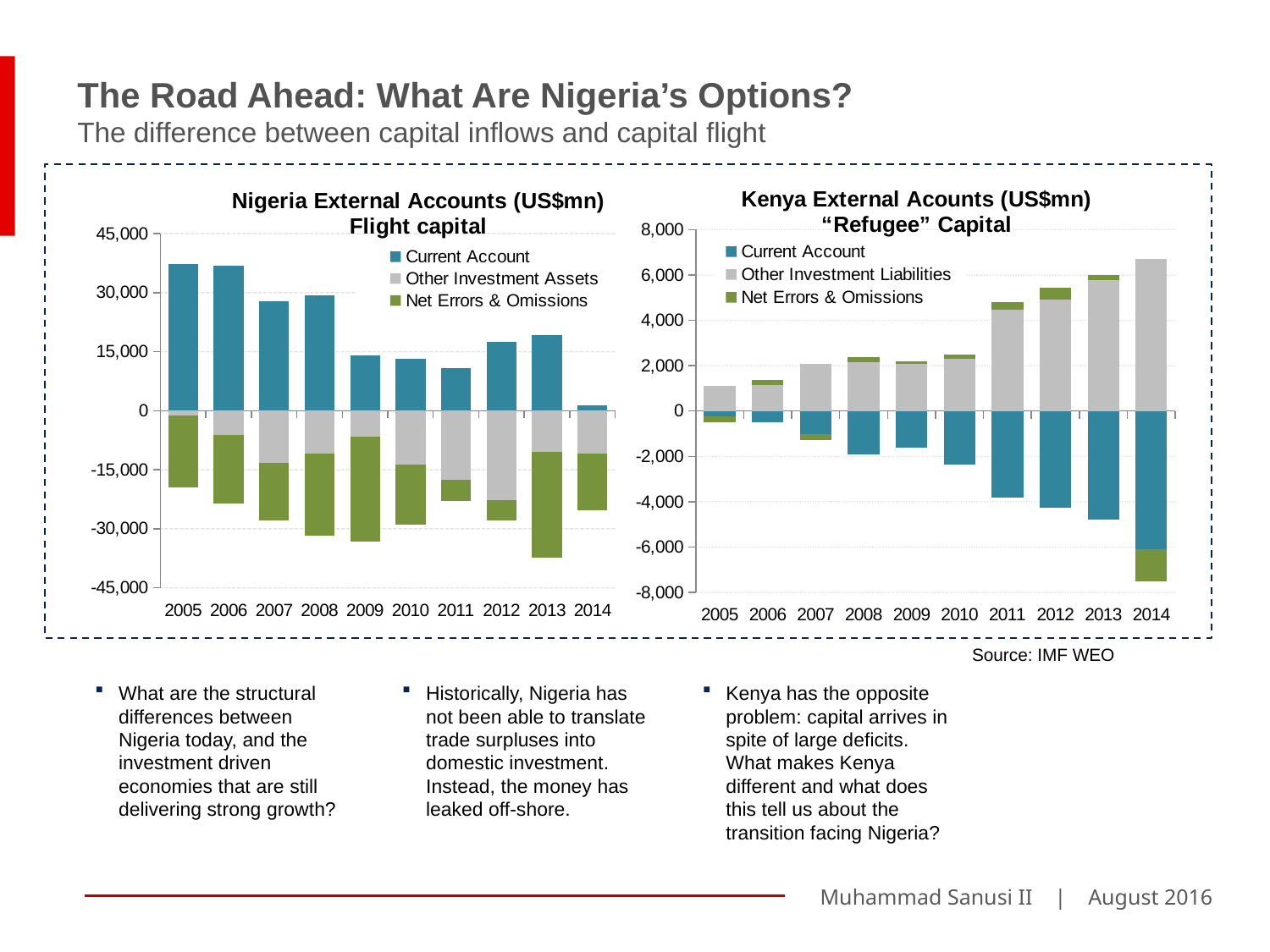
What source is cited below the charts? IMF WEO How many years are shown on the x axis of the Nigeria External Accounts chart? 10 How many series does the legend of the Kenya External Acounts chart list? 3 In the Kenya External Acounts chart, does the Other Investment Liabilities series generally rise or fall from 2005 to 2014? rise In the Kenya External Acounts chart, which year has the highest Other Investment Liabilities value? 2014 In the Nigeria External Accounts chart, is the Current Account value for 2014 greater or less than 15,000? less In the Kenya External Acounts chart, is the Current Account value for 2013 greater or less than -4,000? less In the Kenya External Acounts chart, is the Other Investment Liabilities value for 2014 greater or less than 6,000? greater In the Nigeria External Accounts chart, which year has the lowest Current Account value? 2014 What kind of chart is the Nigeria External Accounts chart on the left? Stacked bar chart